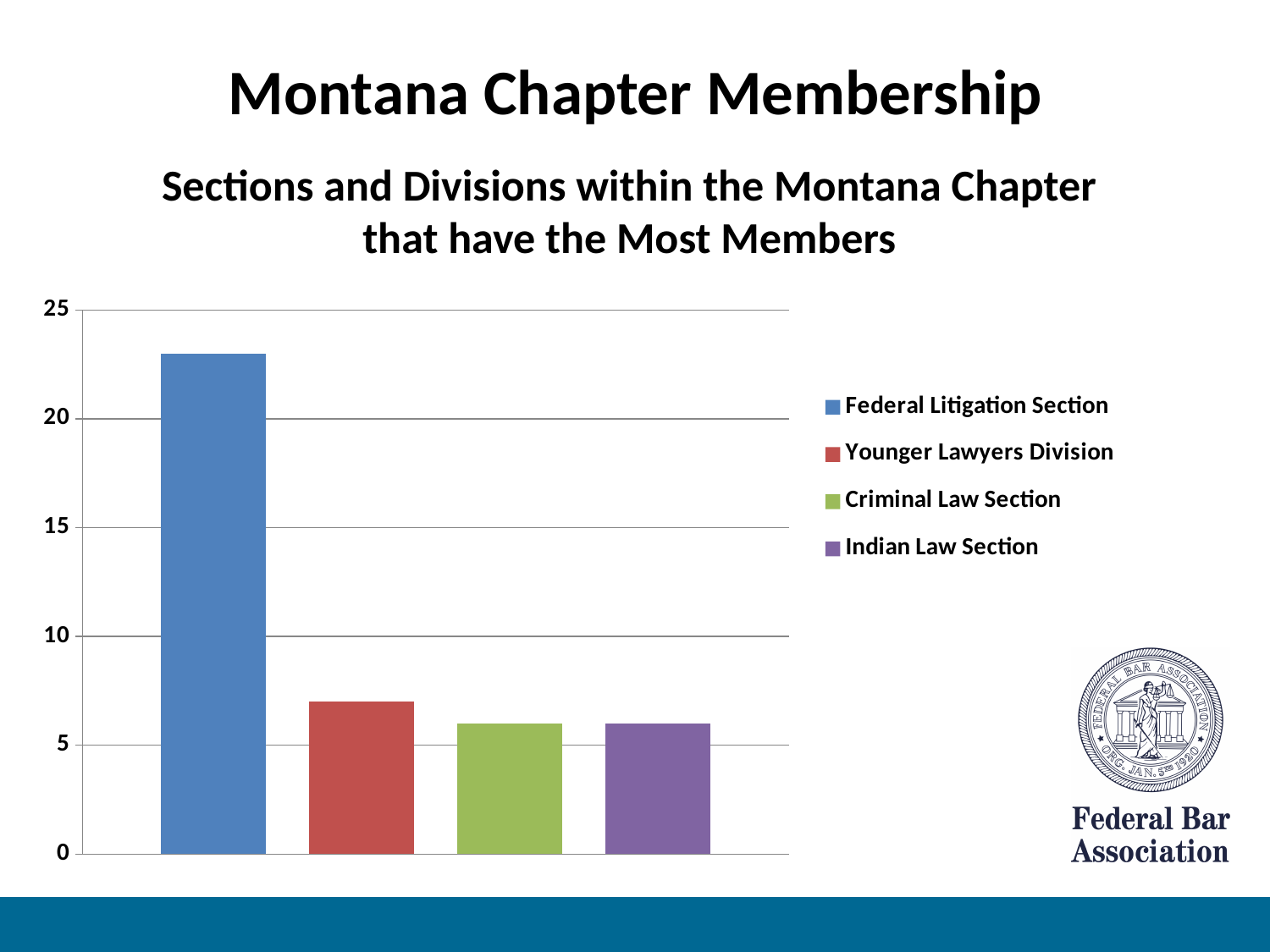
How many entries does the legend list? 4 What is the title of the chart? Sections and Divisions within the Montana Chapter that have the Most Members Do the bar values rise or fall from left to right across the chart? fall Is the value for Criminal Law Section greater or less than 5? greater Is the value for Federal Litigation Section greater or less than 20? greater Is the value for Younger Lawyers Division greater or less than 10? less What kind of chart is shown on the slide? bar chart What colour is the bar for Criminal Law Section? green Which has more members, Federal Litigation Section or Younger Lawyers Division? Federal Litigation Section Which section or division has the highest number of members? Federal Litigation Section How many bars are plotted in the chart? 4